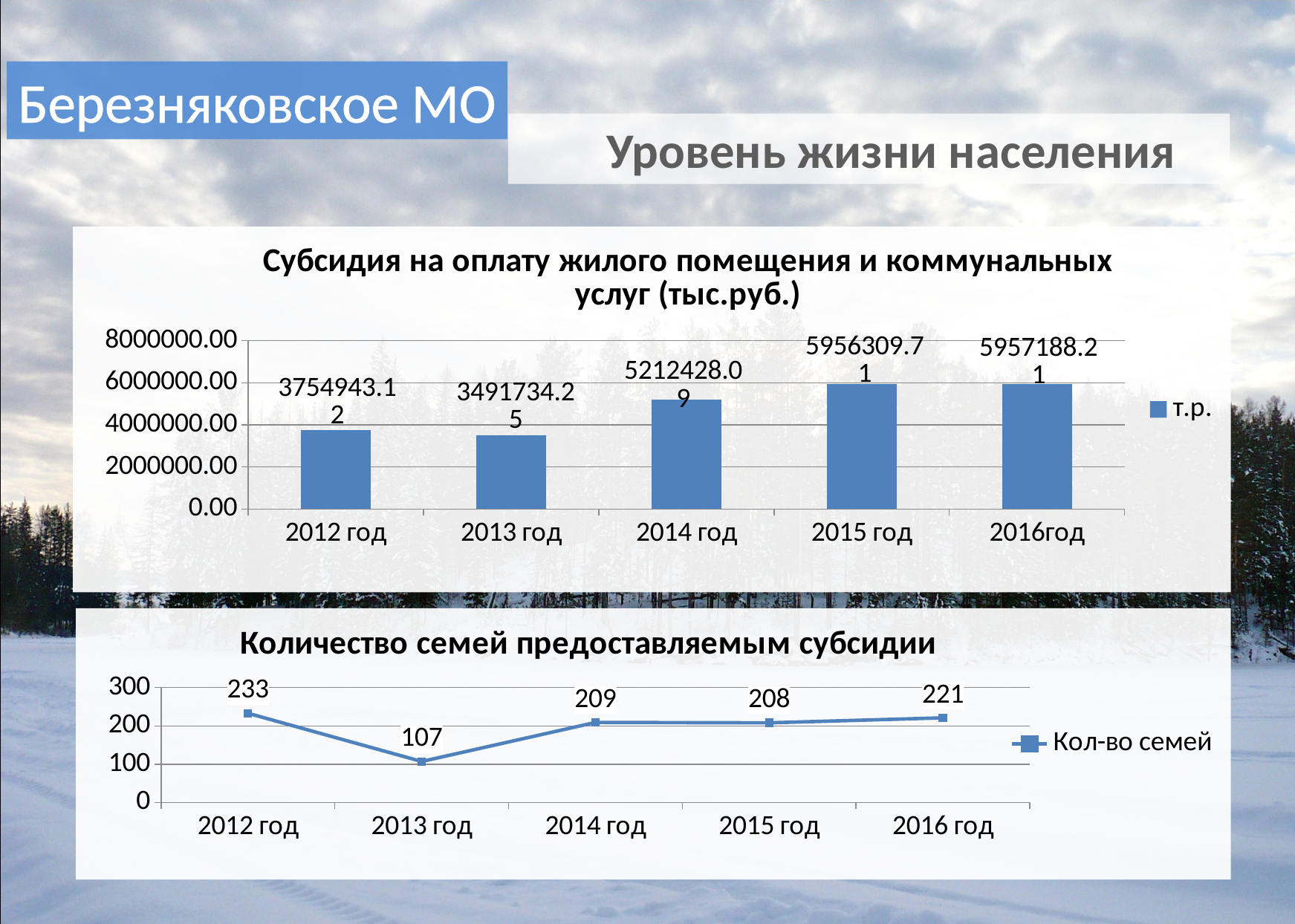
In the bottom chart (Количество семей предоставляемым субсидии), what is the value for 2013 год? 107 In the bottom chart (Количество семей предоставляемым субсидии), which year has the highest value? 2012 год In the top chart (Субсидия на оплату жилого помещения и коммунальных услуг), which year has the lowest value? 2013 год How many data points are plotted in the bottom chart (Количество семей предоставляемым субсидии)? 5 In the top chart (Субсидия на оплату жилого помещения и коммунальных услуг), is the value for 2015 год greater or less than 4000000.00? greater In the top chart (Субсидия на оплату жилого помещения и коммунальных услуг), what is the value for 2012 год? 3754943.12 In the top chart (Субсидия на оплату жилого помещения и коммунальных услуг), what is the difference between the values for 2014 год and 2013 год? 1720693.84 In the top chart (Субсидия на оплату жилого помещения и коммунальных услуг), what is the value for 2014 год? 5212428.09 What kind of chart is the top chart (Субсидия на оплату жилого помещения и коммунальных услуг)? bar chart What kind of chart is the bottom chart (Количество семей предоставляемым субсидии)? line chart In the bottom chart (Количество семей предоставляемым субсидии), which is larger, the value for 2016 год or the value for 2015 год? 2016 год In the bottom chart (Количество семей предоставляемым субсидии), what is the difference between the values for 2012 год and 2013 год? 126